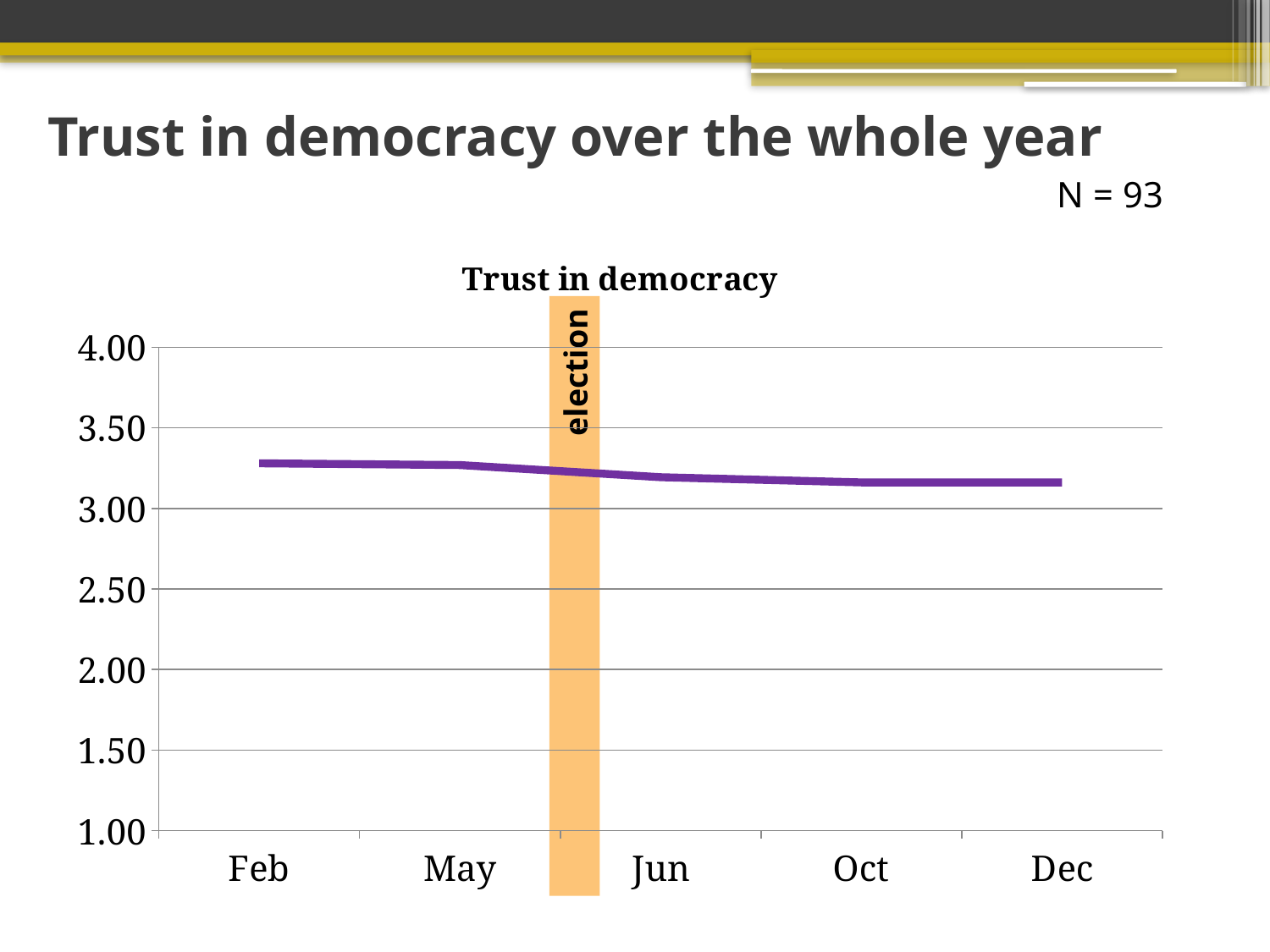
What is the title of the chart? Trust in democracy What is the lowest value shown on the y axis of the chart? 1.00 What event does the orange vertical band on the chart mark? election Which is larger, the value for Feb or the value for Dec? Feb Is the value for Oct greater or less than 3.50? less Is the value for Feb greater or less than 3.00? greater Is the value for Feb greater or less than 3.50? less How many months are labelled on the x axis of the chart? 5 Do the values rise or fall from Feb to Dec? fall What kind of chart is shown on the slide? line chart